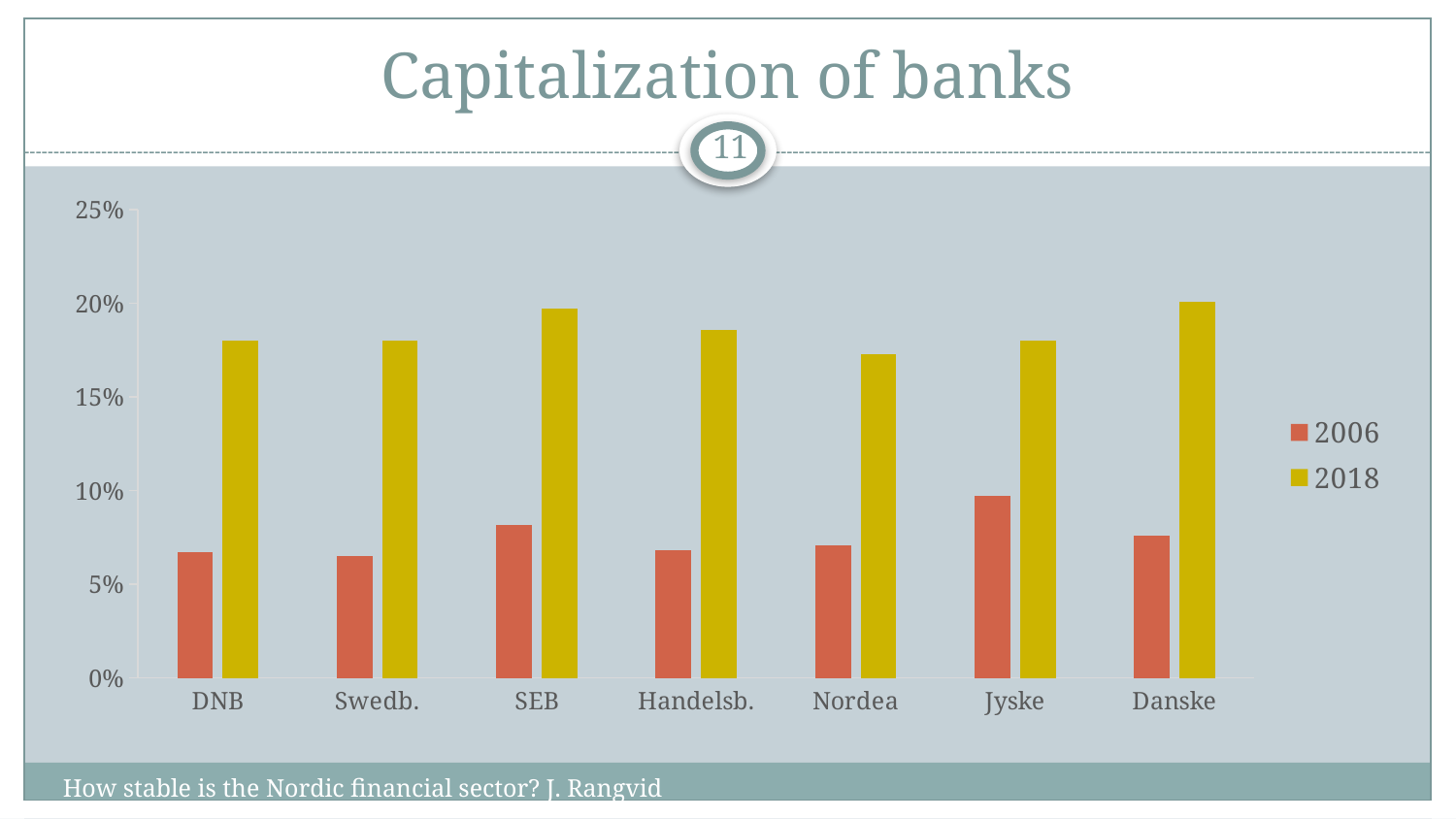
How many series does the legend list? 2 Which is larger, the 2006 value for SEB or the 2006 value for Nordea? SEB How many banks are shown on the x axis of the chart? 7 Which bank has the highest 2006 value? Jyske Is the 2006 value for DNB greater or less than 5%? greater For Danske, which series has the larger value, 2006 or 2018? 2018 Is the 2018 value for Nordea greater or less than 15%? greater What is the title of the chart? Capitalization of banks Which bank has the lowest 2018 value? Nordea Which series is shown in yellow? 2018 What kind of chart is shown on the slide? bar chart